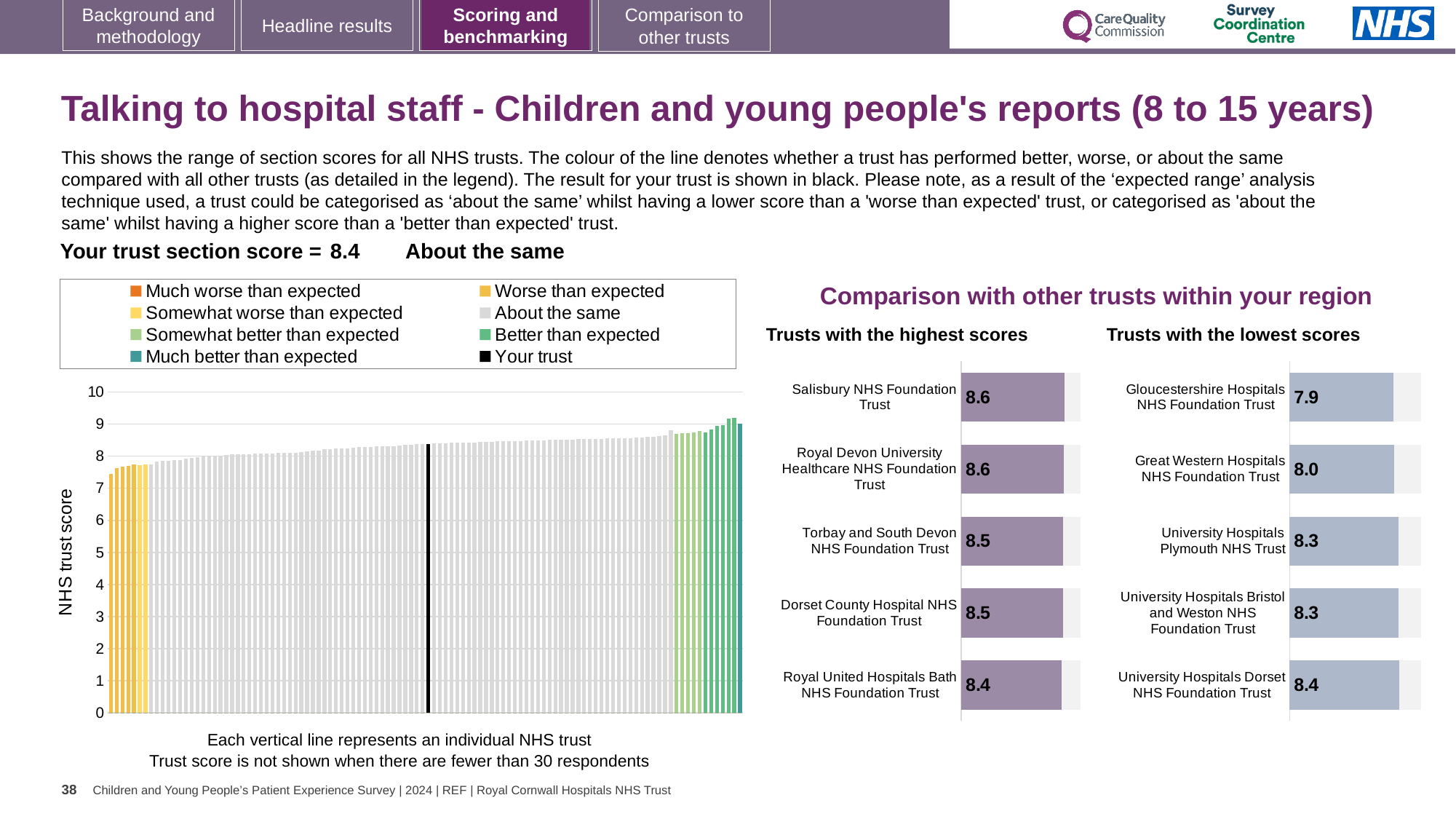
What kind of chart is the main NHS trust score chart on the left? bar chart In the 'Trusts with the highest scores' chart, what is the difference between the scores of Salisbury NHS Foundation Trust and Royal United Hospitals Bath NHS Foundation Trust? 0.2 In the main NHS trust score chart on the left, do the bars rise or fall from left to right? rise In the 'Trusts with the lowest scores' chart, what is the difference between the scores of University Hospitals Dorset NHS Foundation Trust and Gloucestershire Hospitals NHS Foundation Trust? 0.5 In the 'Trusts with the highest scores' chart, how many trusts are shown? 5 What is your trust's section score shown on the slide? 8.4 In the main NHS trust score chart on the left, is the value of the leftmost (lowest) bar greater or less than 8? less In the 'Trusts with the lowest scores' chart, which has the larger score: Great Western Hospitals NHS Foundation Trust or University Hospitals Plymouth NHS Trust? University Hospitals Plymouth NHS Trust In the main NHS trust score chart on the left, how many entries does the legend list? 8 In the 'Trusts with the lowest scores' chart, which trust has the lowest score? Gloucestershire Hospitals NHS Foundation Trust In the 'Trusts with the lowest scores' chart, what is the score for Gloucestershire Hospitals NHS Foundation Trust? 7.9 In the 'Trusts with the highest scores' chart, what is the score for Salisbury NHS Foundation Trust? 8.6